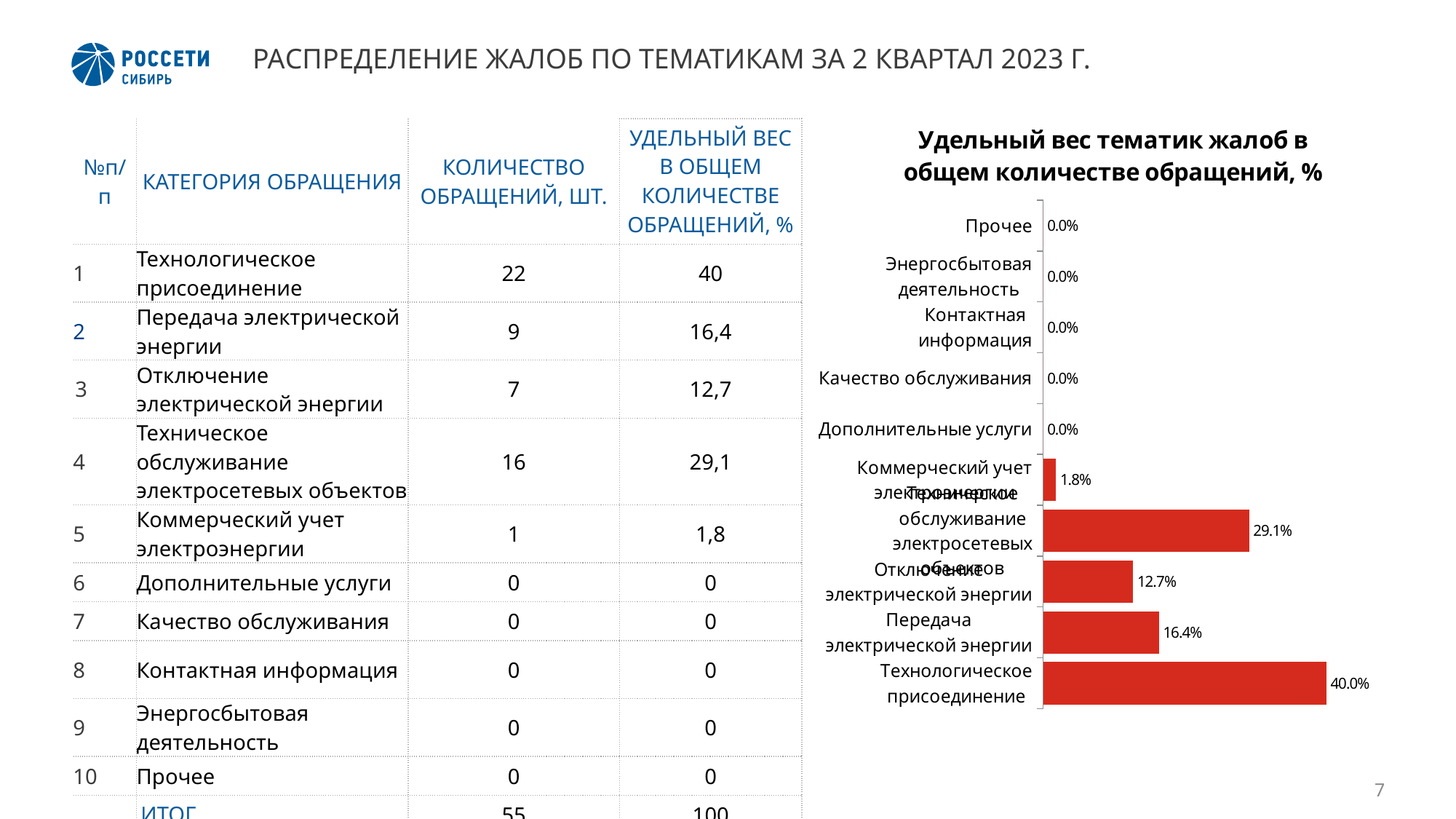
What is the value for Коммерческий учет электроэнергии in the chart? 1.8% What colour are the bars in the chart? red What type of chart is shown on the slide? bar chart How many categories are shown in the chart? 10 What is the title of the chart? Удельный вес тематик жалоб в общем количестве обращений, % What is the difference between the values for Технологическое присоединение and Передача электрической энергии? 23.6% What is the value for Качество обслуживания in the chart? 0.0% Which is larger: the value for Отключение электрической энергии or the value for Передача электрической энергии? Передача электрической энергии What is the value for Отключение электрической энергии in the chart? 12.7% What is the value for Технологическое присоединение in the chart? 40.0% Which category has the highest value in the chart? Технологическое присоединение What is the value for Передача электрической энергии in the chart? 16.4%